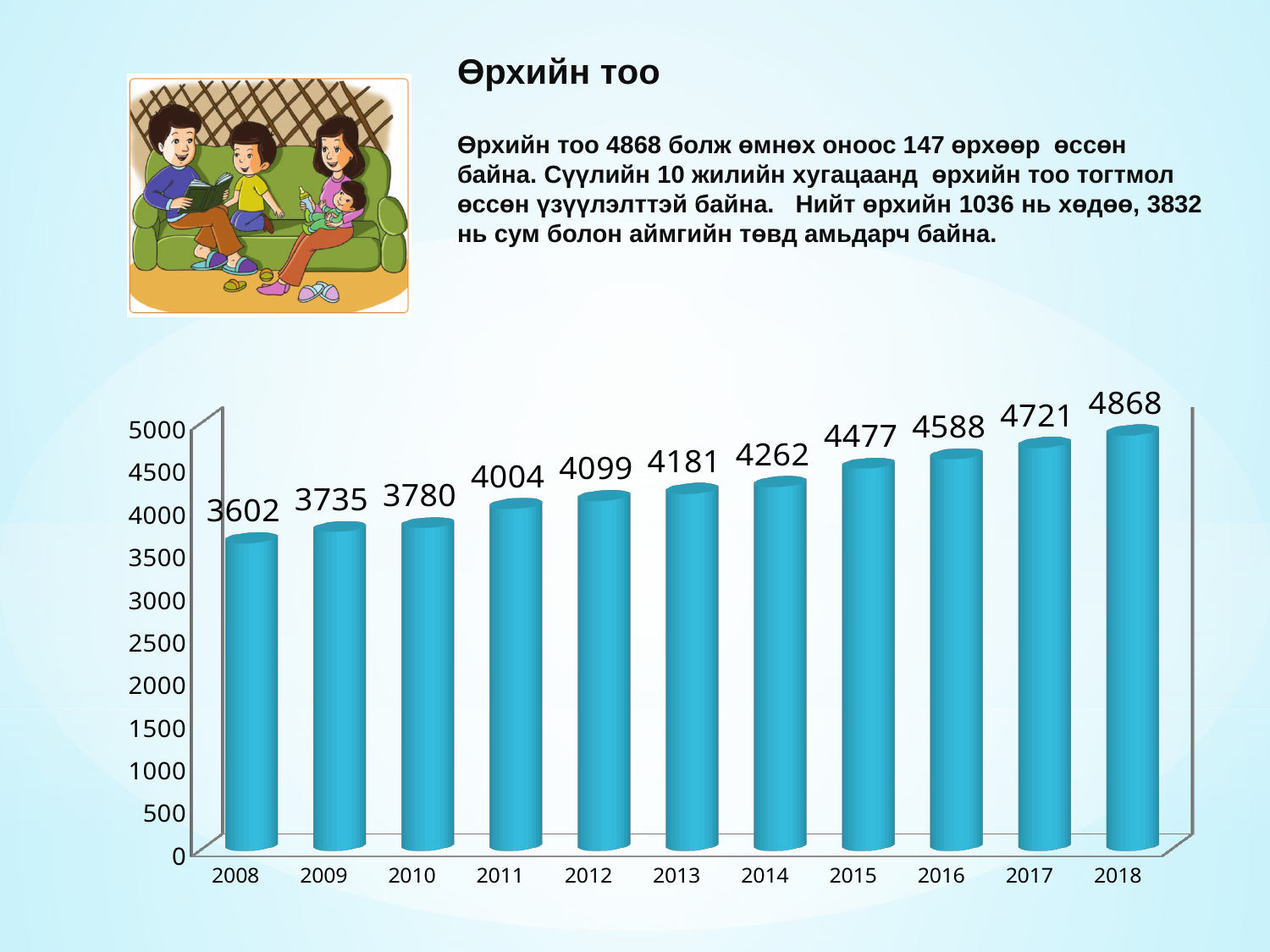
Which is larger, the value for 2012 or the value for 2015? 2015 Is the value for 2010 greater or less than 4000? less What is the value for 2008? 3602 Which year has the highest value? 2018 What is the value for 2014? 4262 What is the difference between the values for 2011 and 2008? 402 What is the value for 2018? 4868 Do the values rise or fall from 2008 to 2018? rise What kind of chart is shown on the slide? bar chart How many years are shown on the x axis? 11 Which year has the lowest value? 2008 What is the difference between the values for 2018 and 2017? 147